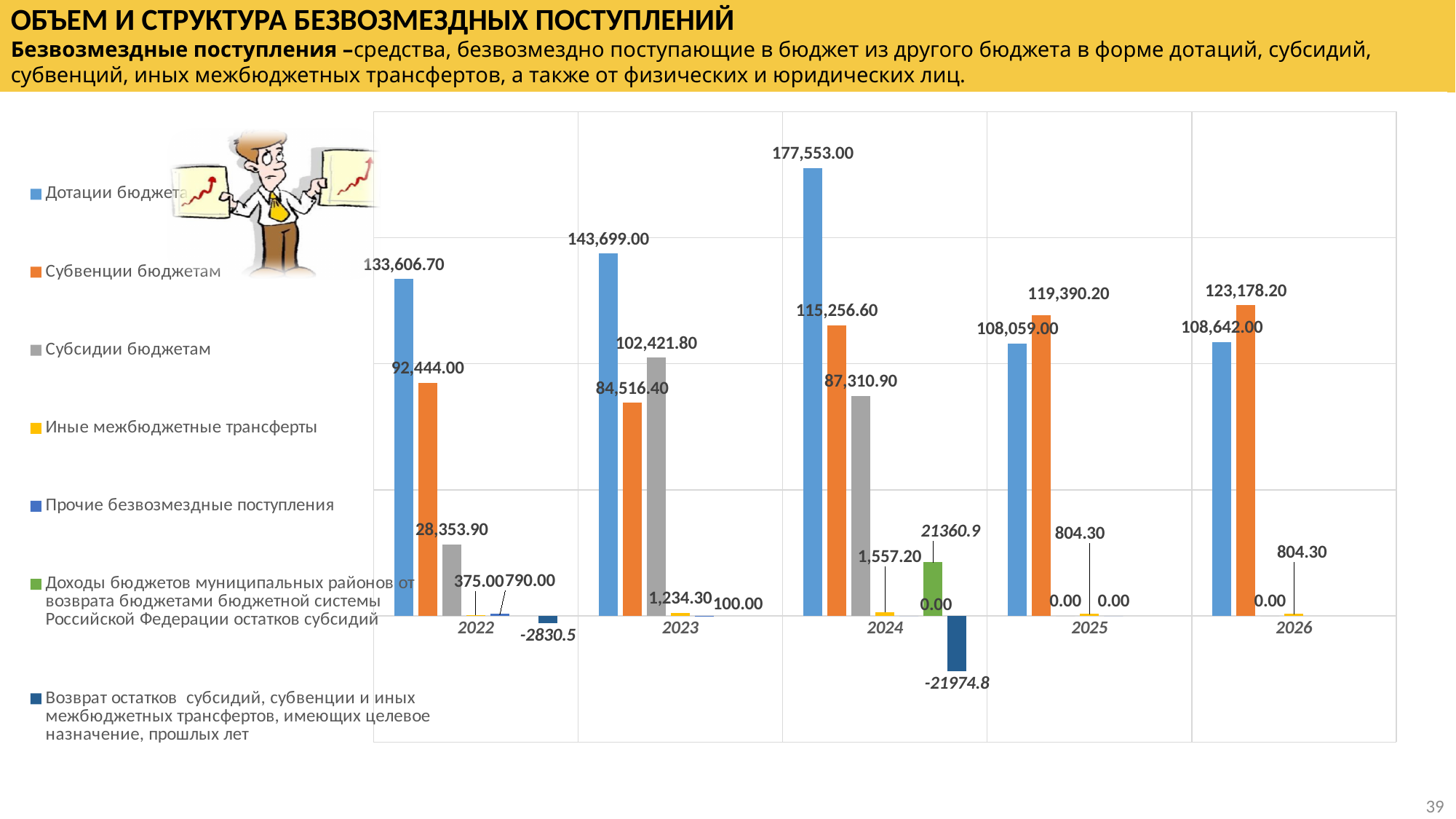
Which is larger in 2025: Дотации бюджета or Субвенции бюджетам? Субвенции бюджетам What is the value of Субвенции бюджетам for 2026? 123,178.20 How many years are shown on the x axis of the chart? 5 Does Субвенции бюджетам rise or fall from 2024 to 2026? rise In which year is Дотации бюджета lowest? 2025 What is the difference between Дотации бюджета in 2024 and in 2023? 33,854.00 What is the value of Дотации бюджета for 2024? 177,553.00 What type of chart is shown on the slide? bar chart In which year is Дотации бюджета highest? 2024 What is the value of Возврат остатков субсидий, субвенции и иных межбюджетных трансфертов for 2024? -21974.8 What is the value of Субсидии бюджетам for 2023? 102,421.80 How many series does the chart legend list? 7